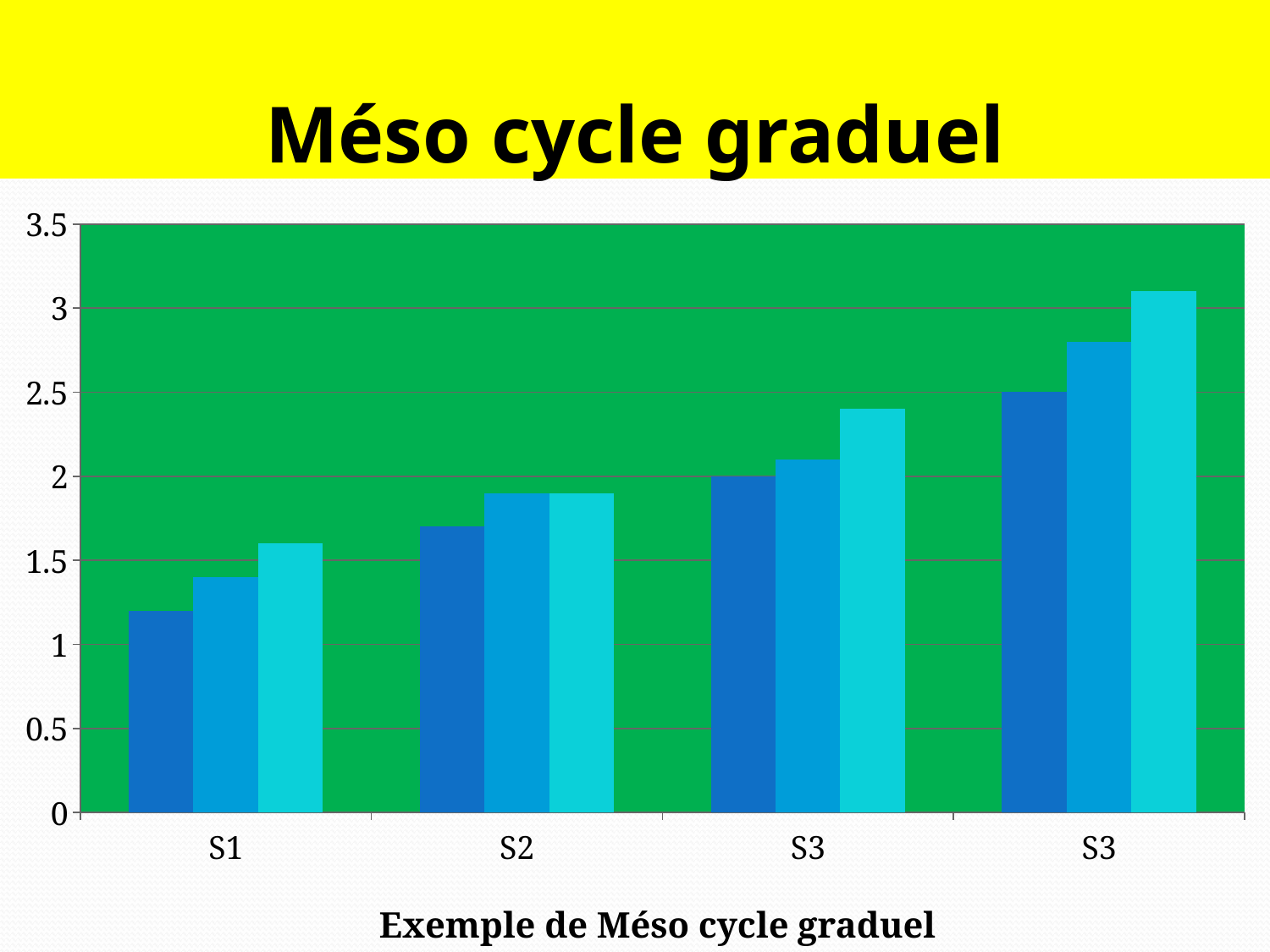
Which group of bars has the tallest bars? the rightmost group How many bars are there in each group? 3 Is the value of the cyan (rightmost) bar in group S1 greater or less than 1.5? greater Is the value of the cyan (rightmost) bar in the rightmost group greater or less than 3? greater Is the value of the dark blue (leftmost) bar in group S2 greater or less than 1.5? greater What kind of chart is shown on the slide? bar chart Do the bar heights rise or fall from left to right across the groups? rise What is the title of the chart's horizontal axis? Exemple de Méso cycle graduel How many groups of bars are plotted along the x axis? 4